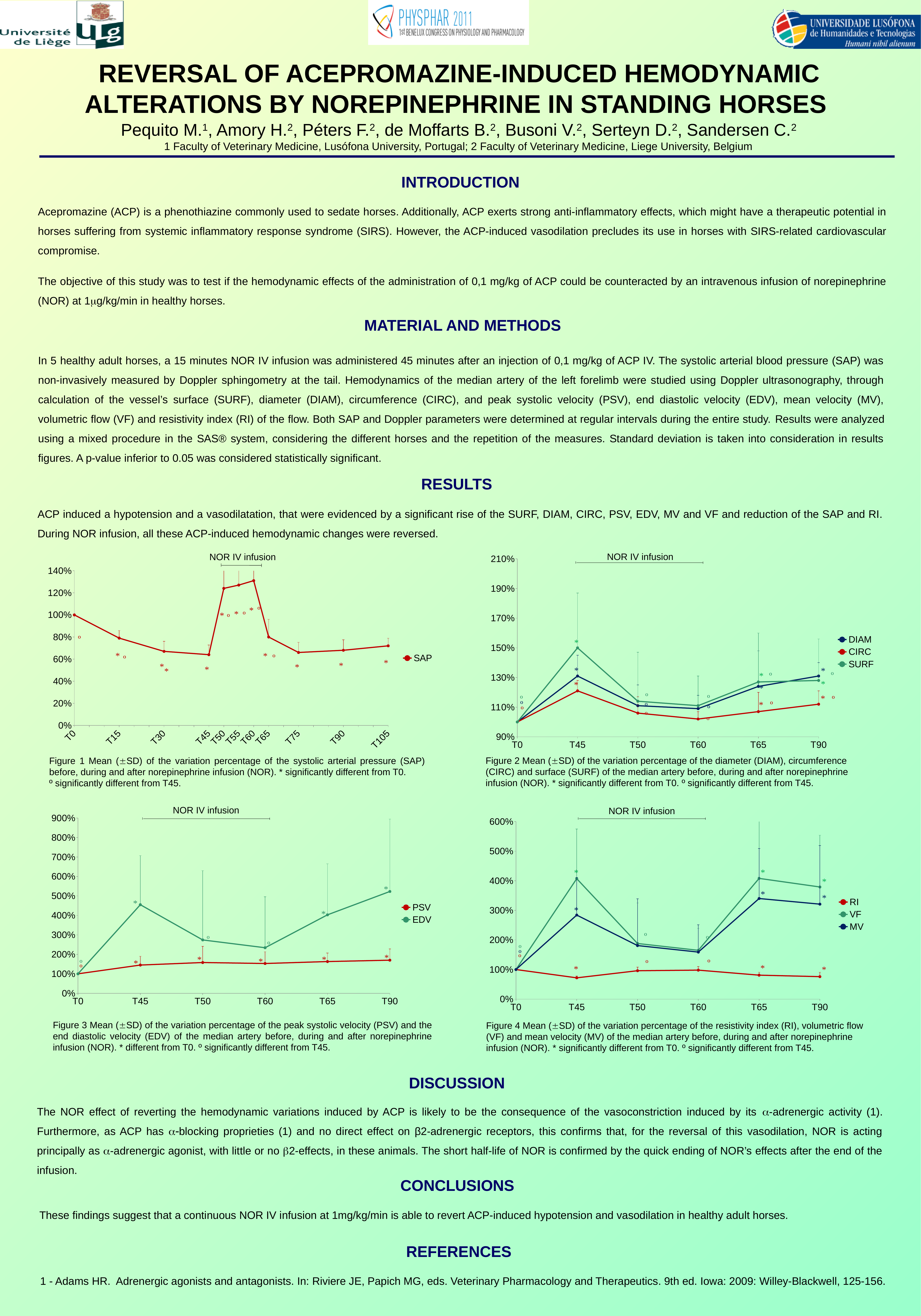
In Figure 1 (SAP), is the value at T30 greater or less than 80%? less In Figure 3 (PSV, EDV), at which time point is EDV highest? T90 In Figure 4 (RI, VF, MV), which series has the larger value at T45, VF or MV? VF What kind of chart is Figure 1 (SAP)? line chart In Figure 3 (PSV, EDV), is the PSV value at T45 greater or less than 200%? less In Figure 2 (DIAM, CIRC, SURF), which series has the larger value at T45, SURF or CIRC? SURF In Figure 1 (SAP), is the value at T50 greater or less than 120%? greater In Figure 1 (SAP), what is the value at T0? 100% In Figure 1 (SAP), how many time points are plotted along the x axis? 11 In Figure 2 (DIAM, CIRC, SURF), how many series does the legend list? 3